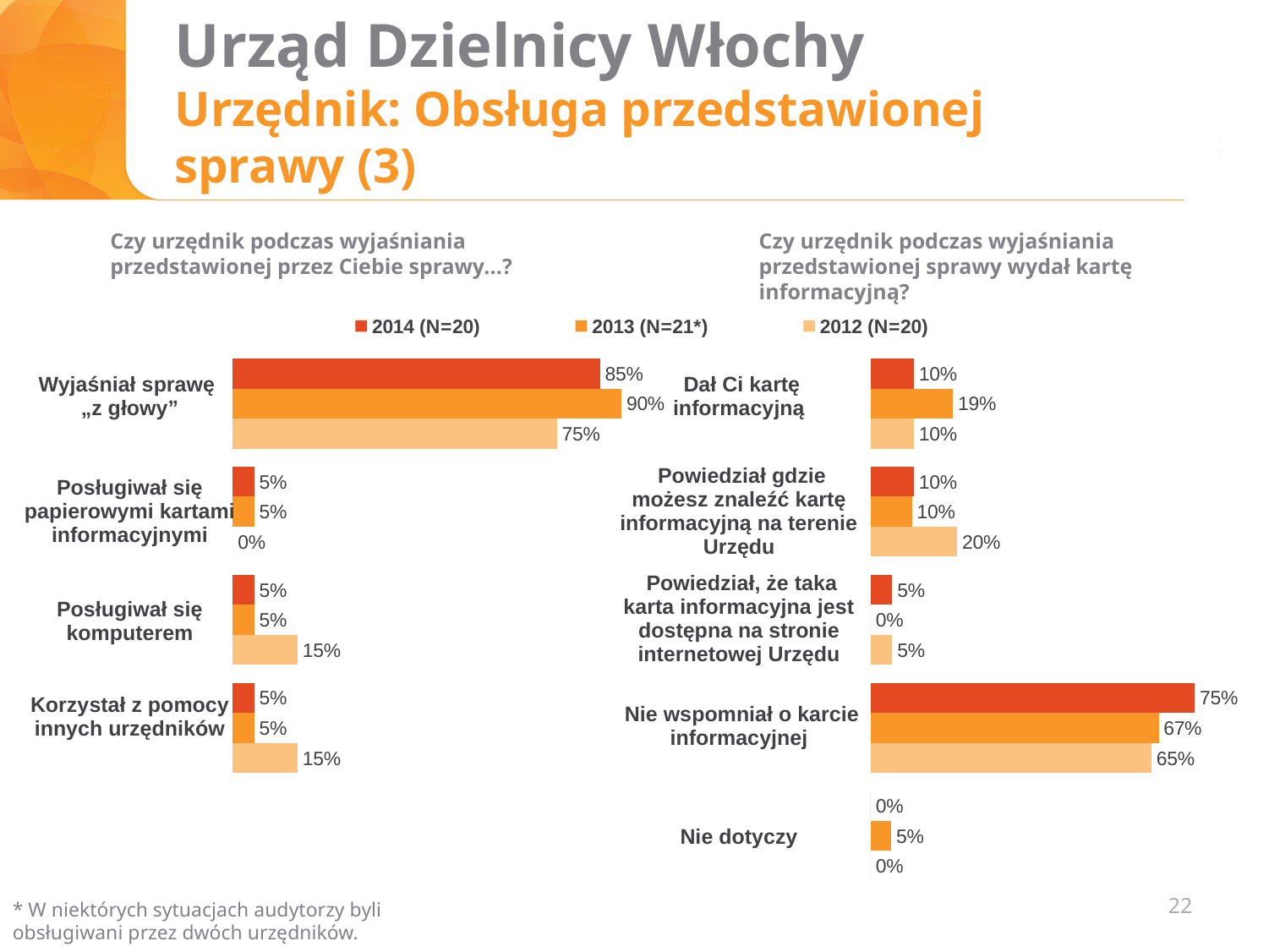
In the left chart, what is the 2012 value for "Posługiwał się komputerem"? 15% In the left chart, what is the difference between the 2013 and 2012 values for "Wyjaśniał sprawę „z głowy”"? 15% In the right chart, what is the difference between the 2014 and 2012 values for "Nie wspomniał o karcie informacyjnej"? 10% In the left chart, which category has the highest 2013 value? Wyjaśniał sprawę „z głowy” In the right chart, which is larger for "Powiedział gdzie możesz znaleźć kartę informacyjną na terenie Urzędu": the 2012 value or the 2014 value? 2012 How many series does the legend list? 3 How many categories does the right chart show? 5 In the right chart, which category has the lowest 2014 value? Nie dotyczy In the left chart ("Czy urzędnik podczas wyjaśniania przedstawionej przez Ciebie sprawy...?"), what is the 2014 value for "Wyjaśniał sprawę „z głowy”"? 85% In the right chart, what is the 2014 value for "Nie wspomniał o karcie informacyjnej"? 75% In the right chart ("Czy urzędnik podczas wyjaśniania przedstawionej sprawy wydał kartę informacyjną?"), what is the 2013 value for "Dał Ci kartę informacyjną"? 19% What type of chart is the left chart? Bar chart